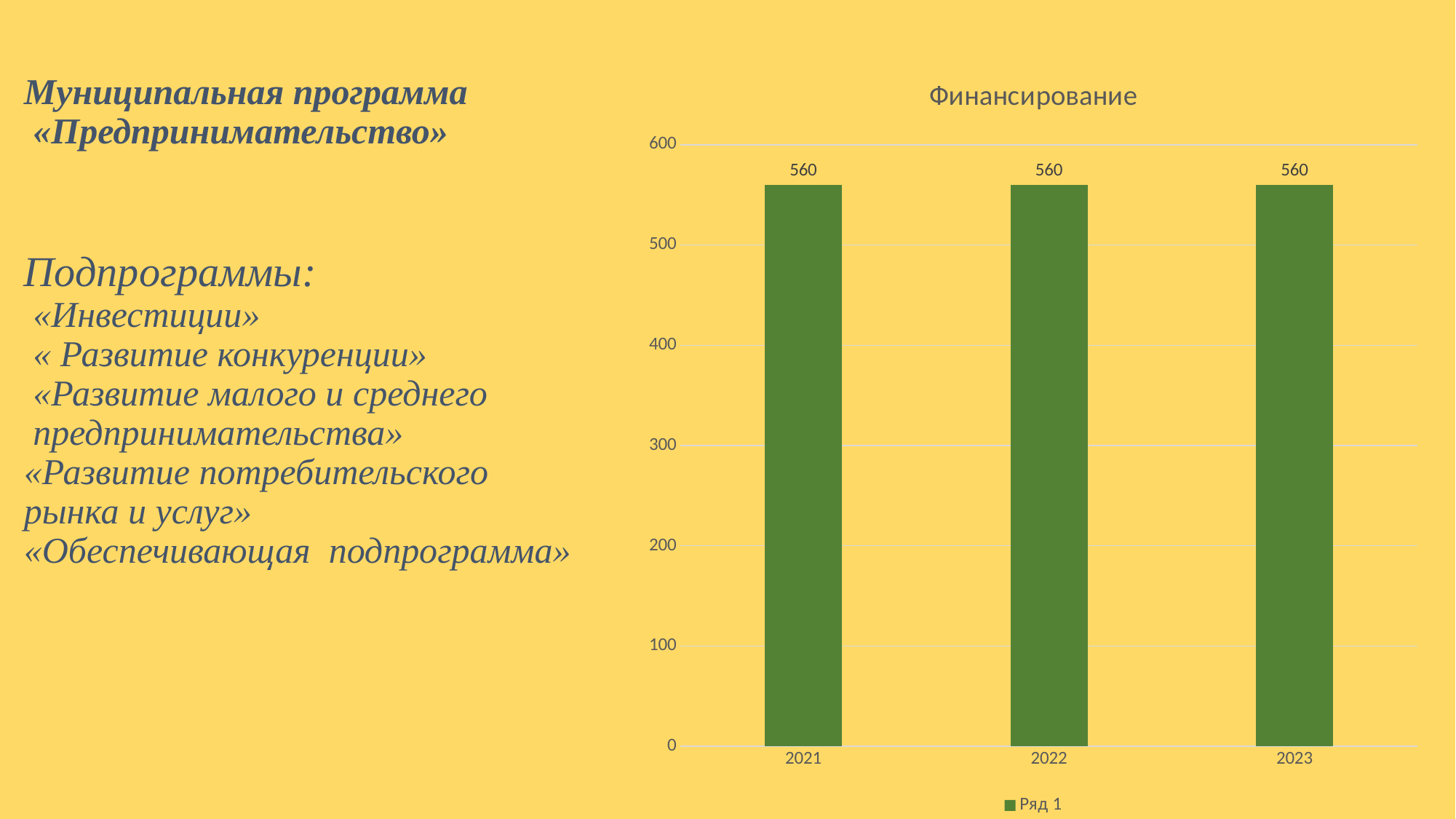
Is the value for 2023 greater or less than 600? less What is the name of the series listed in the legend? Ряд 1 What is the value for 2021 in the Финансирование chart? 560 What is the value for 2023 in the Финансирование chart? 560 How many series does the legend list? 1 Do the values rise, fall or stay the same from 2021 to 2023? stay the same What is the difference between the values for 2021 and 2023? 0 How many categories are shown on the x axis of the chart? 3 What is the title of the chart? Финансирование What is the value for 2022 in the Финансирование chart? 560 What kind of chart is shown on the slide? bar chart Is the value for 2022 greater or less than 500? greater